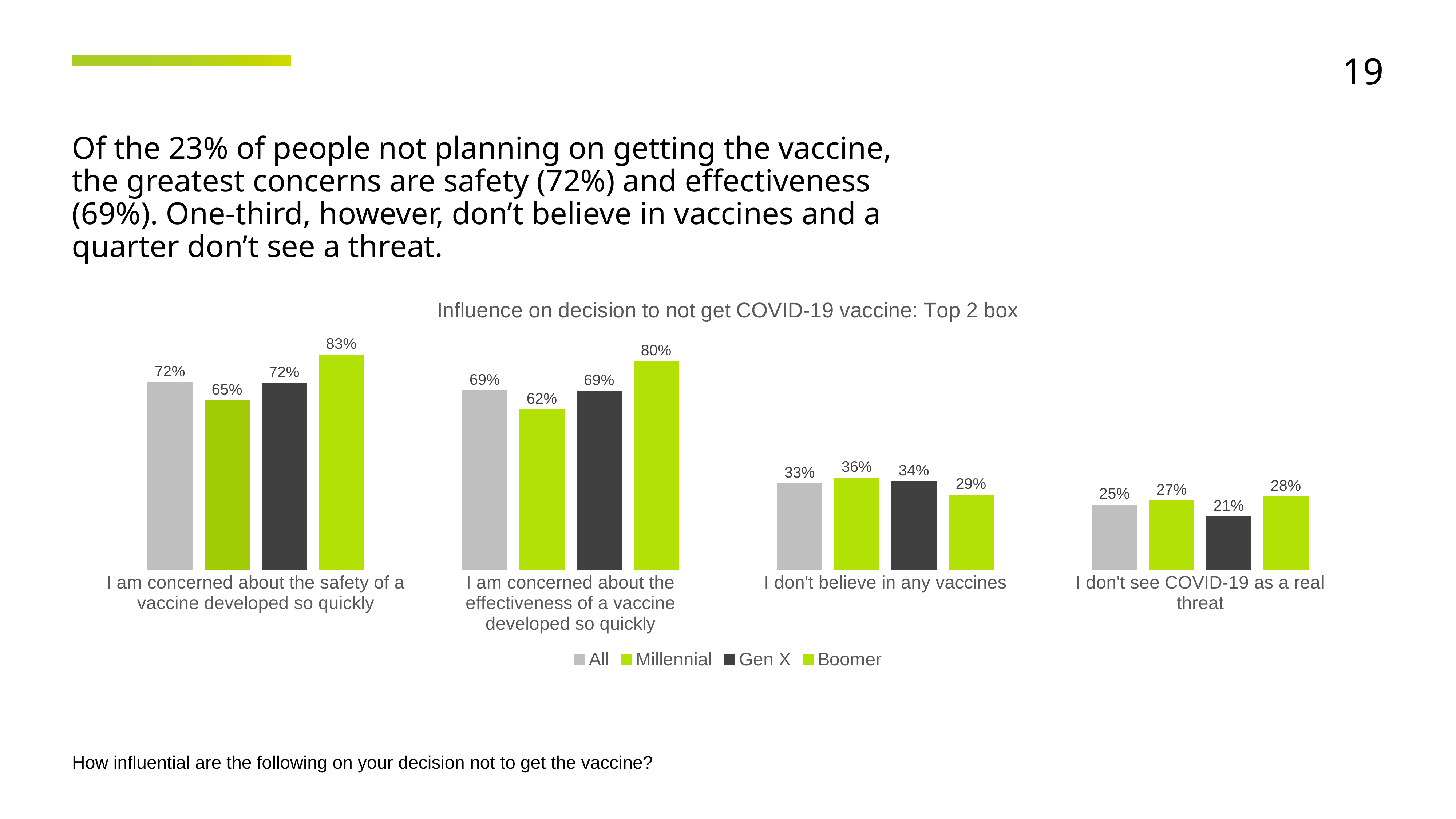
How many series does the chart legend list? 4 What is the value for Millennial in the category "I am concerned about the effectiveness of a vaccine developed so quickly"? 62% What is the value for Boomer in the category "I am concerned about the safety of a vaccine developed so quickly"? 83% What is the title of the chart? Influence on decision to not get COVID-19 vaccine: Top 2 box Which category has the highest value for the All series? I am concerned about the safety of a vaccine developed so quickly What is the value for Gen X in the category "I don't see COVID-19 as a real threat"? 21% What is the value for All in the category "I don't believe in any vaccines"? 33% What is the difference between the Boomer and Millennial values in the category "I am concerned about the safety of a vaccine developed so quickly"? 18% What kind of chart is shown on the slide? Bar chart Which series has the lowest value in the category "I don't see COVID-19 as a real threat"? Gen X How many categories are shown on the x axis of the chart? 4 In the category "I don't believe in any vaccines", which is larger: the Millennial value or the Boomer value? Millennial